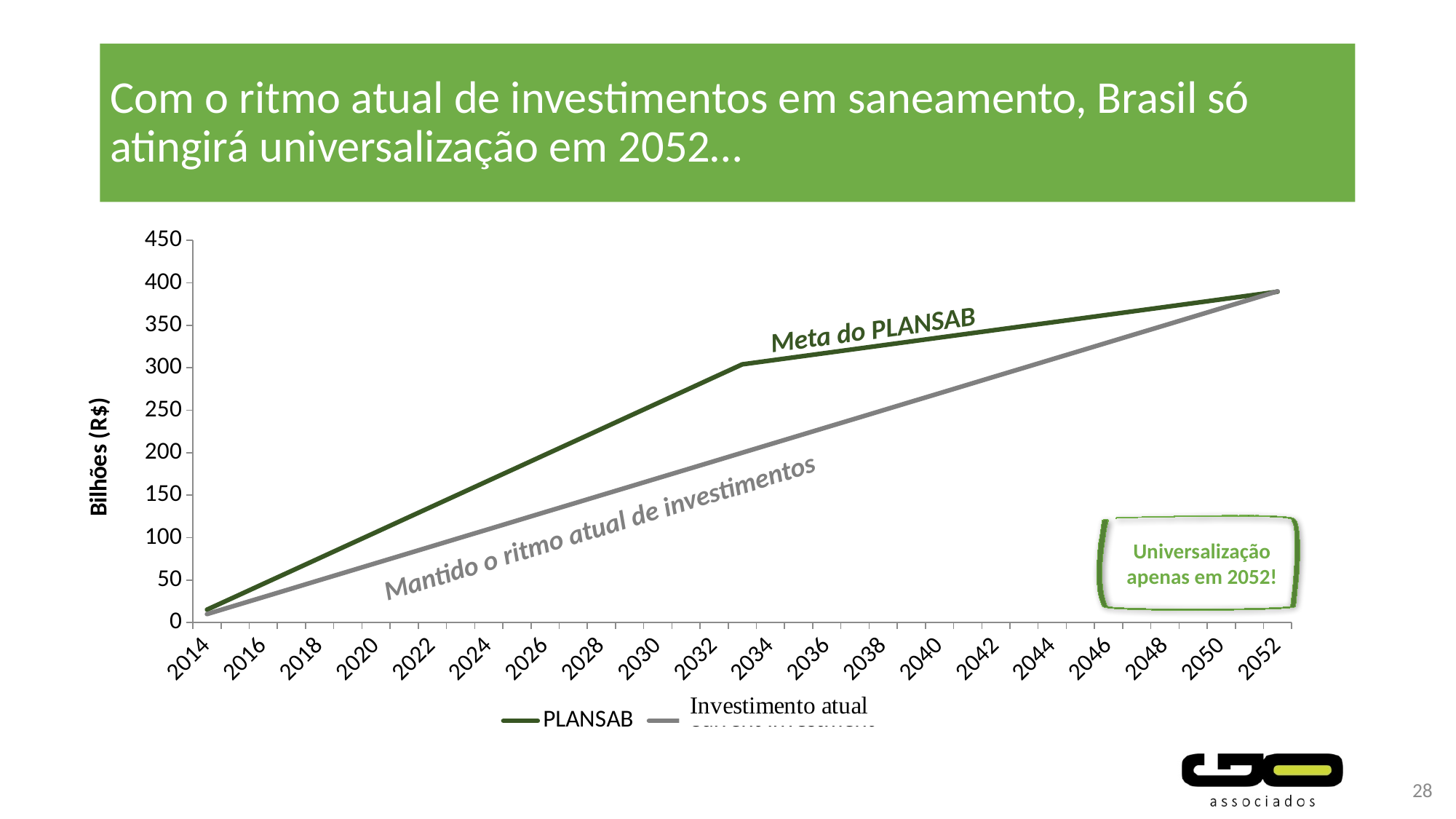
What is the label of the vertical axis of the chart? Bilhões (R$) How many year labels are shown on the x axis of the chart? 20 Does the PLANSAB line rise or fall from 2014 to 2052? rise Is the Investimento atual value in 2024 greater or less than 150? less Is the Investimento atual value in 2040 greater or less than 300? less Does the Investimento atual line rise or fall from 2014 to 2052? rise How many series does the chart legend list? 2 Is the PLANSAB value in 2024 greater or less than 100? greater What kind of chart is shown on the slide? line chart What are the two series named in the chart legend? PLANSAB and Investimento atual In 2030, which series has the higher value, PLANSAB or Investimento atual? PLANSAB